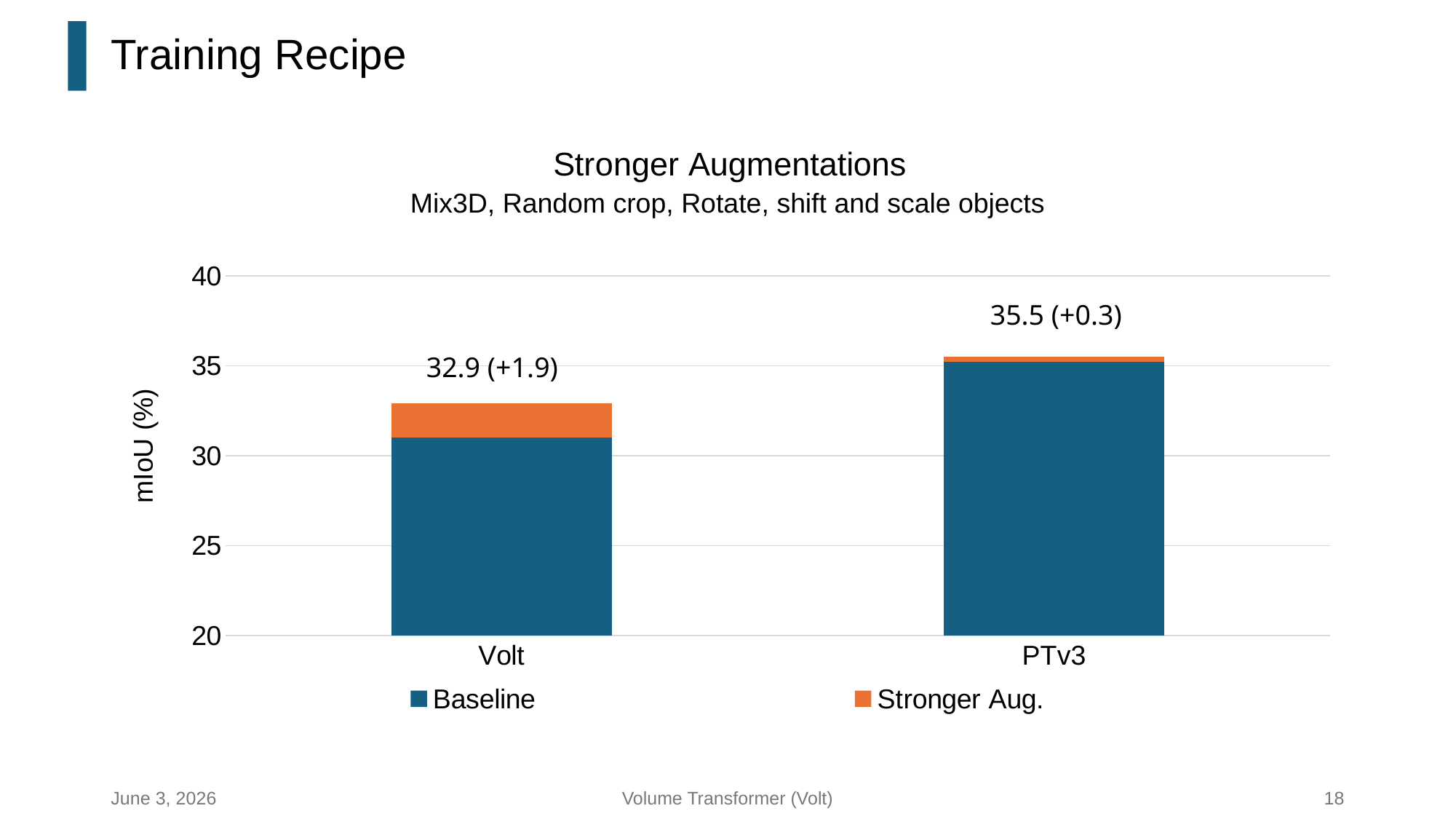
Is the Baseline value for Volt greater or less than 30? greater Which category gains more from stronger augmentations, Volt or PTv3? Volt What improvement from stronger augmentations is labelled for PTv3? +0.3 How many categories are shown on the x axis of the chart? 2 What improvement from stronger augmentations is labelled for Volt? +1.9 What is the label on the y axis of the chart? mIoU (%) Which category has the higher total mIoU (%)? PTv3 What is the total mIoU (%) labelled for Volt with stronger augmentations? 32.9 What kind of chart is shown on the slide? bar chart What is the total mIoU (%) labelled for PTv3 with stronger augmentations? 35.5 How many series does the chart's legend list? 2 What is the difference between the total mIoU (%) of PTv3 and Volt? 2.6